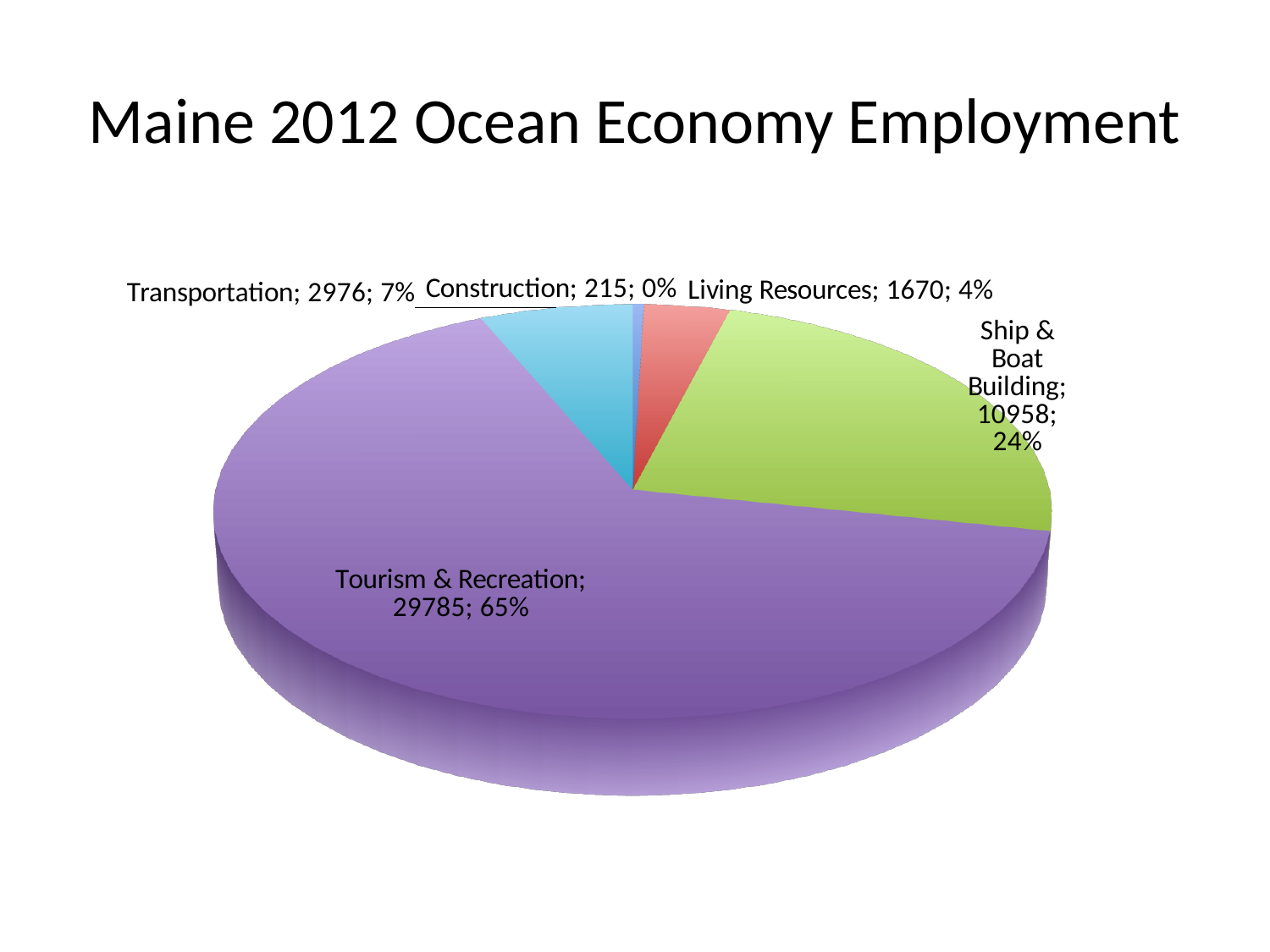
What is the employment value for Transportation? 2976 What is the title of the chart? Maine 2012 Ocean Economy Employment How many slices does the pie chart have? 5 What is the difference in employment between Ship & Boat Building and Transportation? 7982 Which category has the smallest slice? Construction Which category has the largest slice? Tourism & Recreation What kind of chart is shown on the slide? pie chart What is the employment value for Construction? 215 What is the employment value for Tourism & Recreation? 29785 What is the employment value for Ship & Boat Building? 10958 What share of the pie does Ship & Boat Building represent? 24% What share of the pie does Living Resources represent? 4%